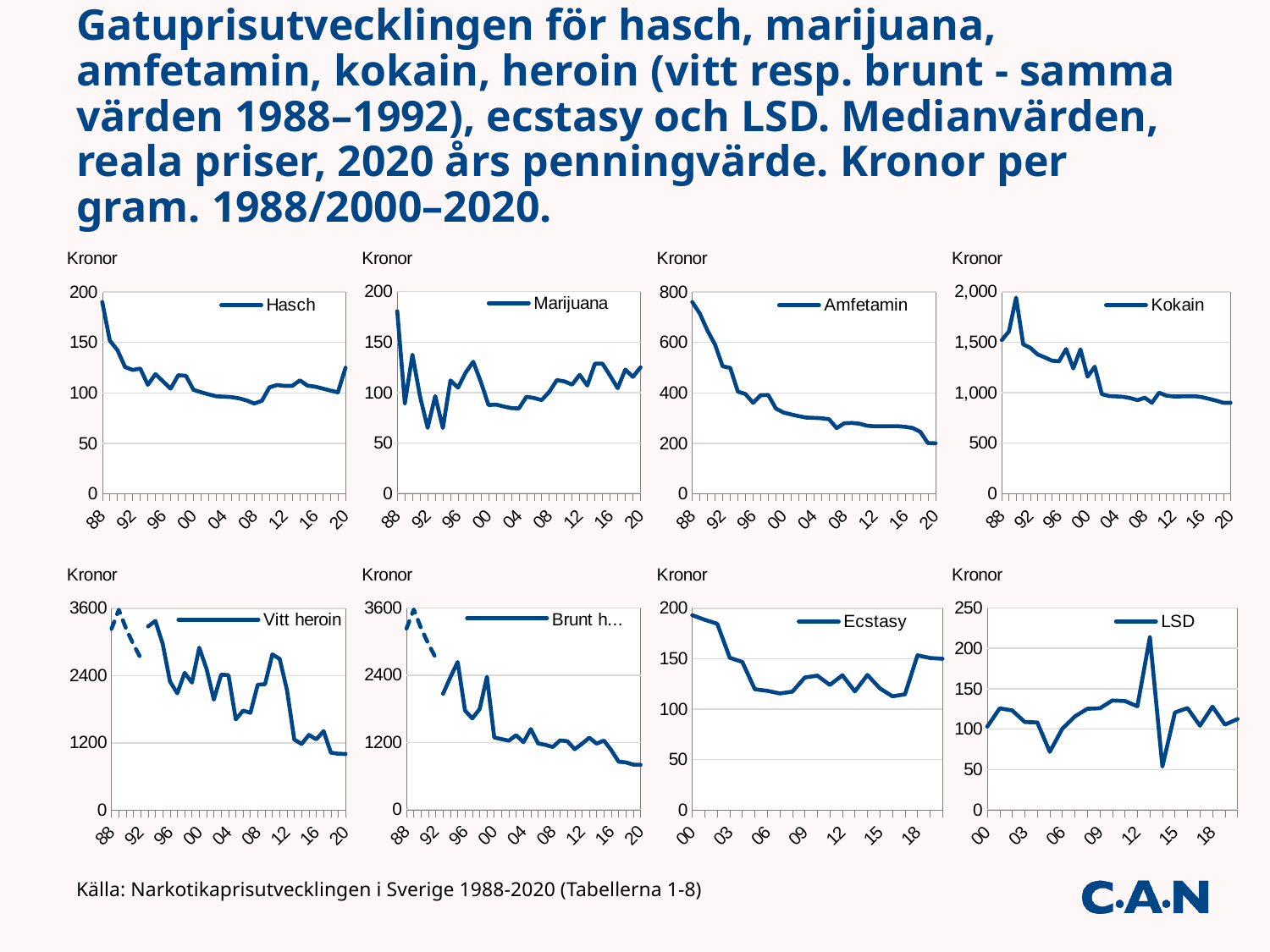
In the Vitt heroin chart, is the value for 2020 greater or less than 1200? less In the Amfetamin chart, is the value for 1988 greater or less than 600? greater In the Amfetamin chart, do the values generally rise or fall from 1988 to 2020? fall What kind of chart is the Hasch chart? line chart In the Kokain chart, is the value for 2020 greater or less than 1,000? less How many series does the legend of the Amfetamin chart list? 1 What label appears above the y axis of each chart? Kronor How many charts are shown on the slide? 8 In the Kokain chart, which is larger, the value for 1988 or the value for 2020? 1988